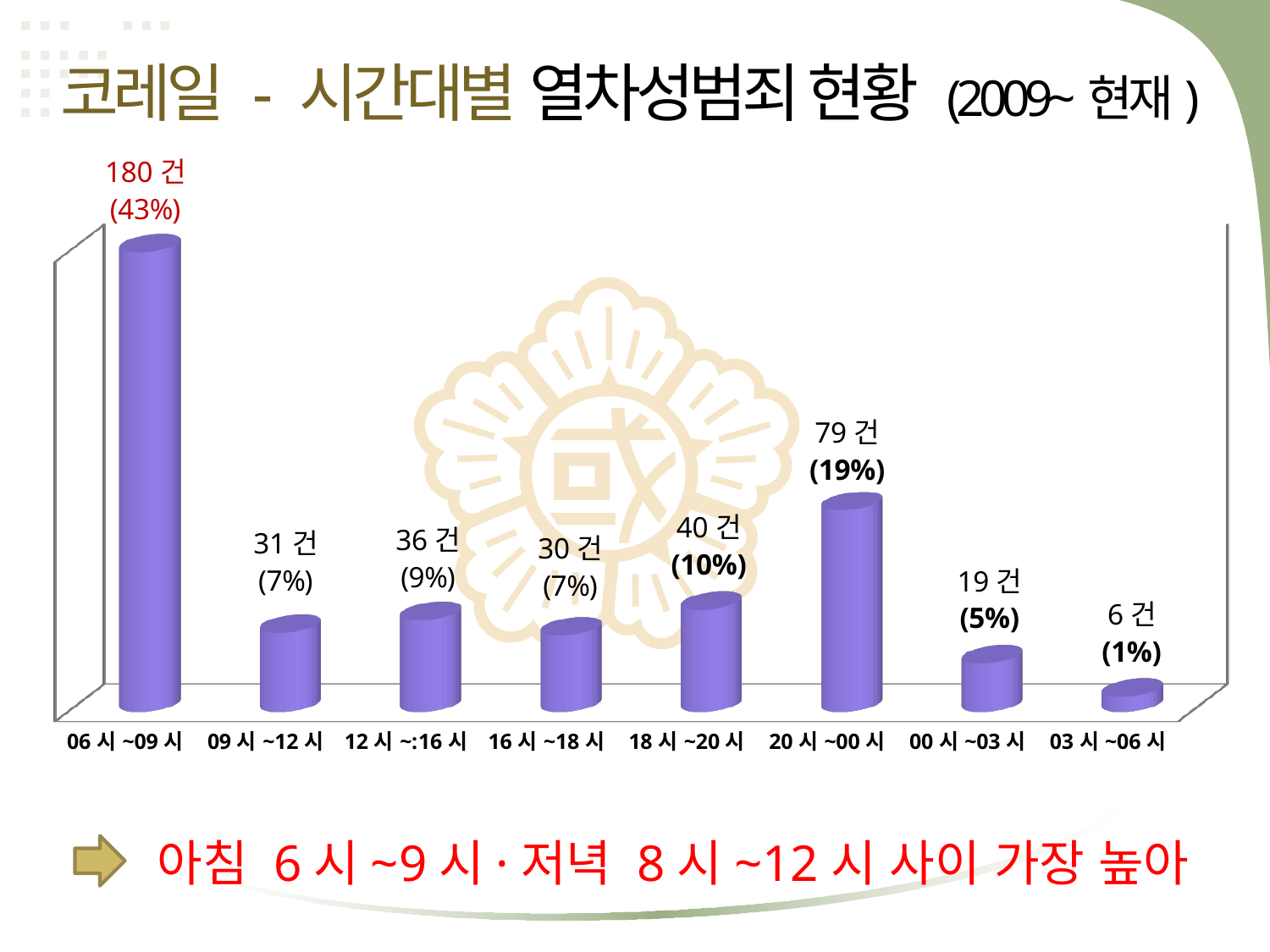
What kind of chart is shown on the slide? Bar chart What is the difference in cases between the 09시~12시 slot and the 16시~18시 slot? 1 건 What percentage is shown for the 00시~03시 time slot? 5% What is the value shown for the 06시~09시 time slot? 180 건 What is the difference in cases between the 06시~09시 slot and the 20시~00시 slot? 101 건 What percentage is shown for the 20시~00시 time slot? 19% Which has more cases, the 12시~16시 slot or the 16시~18시 slot? 12시~16시 What period does the chart title say the data covers? 2009~ 현재 What is the value shown for the 18시~20시 time slot? 40 건 How many time slots are shown on the chart? 8 Which time slot has the highest number of cases? 06시~09시 Which time slot has the lowest number of cases? 03시~06시